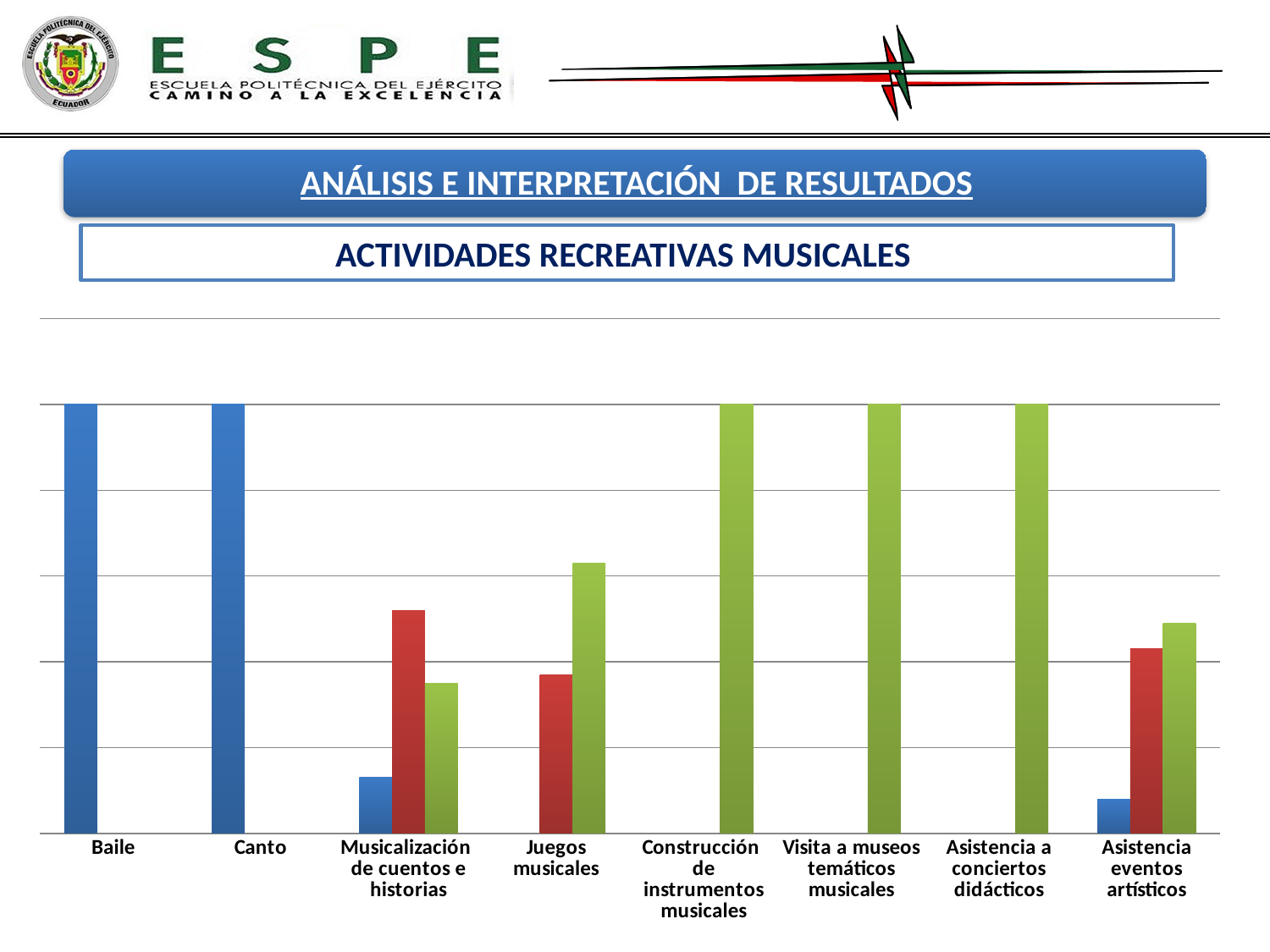
How many categories show only a blue bar? 2 What is the title shown above the chart? ACTIVIDADES RECREATIVAS MUSICALES Which is taller, the green bar for "Juegos musicales" or the green bar for "Asistencia eventos artísticos"? Juegos musicales Which is taller, the green bar for "Construcción de instrumentos musicales" or the green bar for "Juegos musicales"? Construcción de instrumentos musicales Which is taller, the red bar for "Asistencia eventos artísticos" or the red bar for "Juegos musicales"? Asistencia eventos artísticos How many categories are shown along the x axis of the chart? 8 How many different bar colours appear in the chart? 3 What kind of chart is shown on the slide? bar chart How many categories show only a green bar? 3